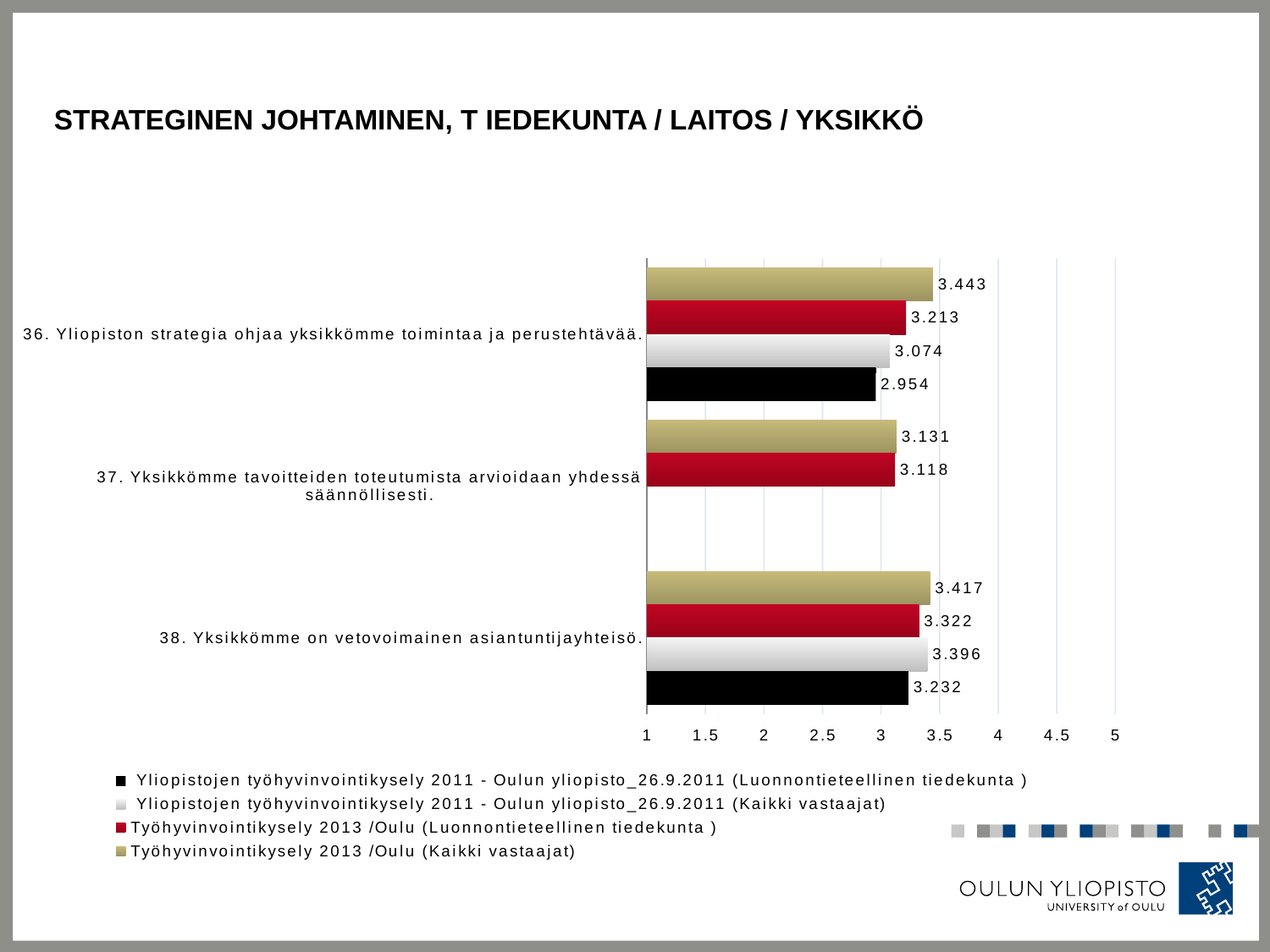
For statement 38, which is larger: the 2011 'Kaikki vastaajat' value or the 2013 'Luonnontieteellinen tiedekunta' value? 2011 'Kaikki vastaajat' (3.396) How many categories (statements) are shown on the chart? 3 What is the value for statement 37 in the series 'Työhyvinvointikysely 2013 /Oulu (Luonnontieteellinen tiedekunta )'? 3.118 Which statement has no values shown for the 2011 survey series? 37. Yksikkömme tavoitteiden toteutumista arvioidaan yhdessä säännöllisesti. What is the value for statement 36 in the series 'Yliopistojen työhyvinvointikysely 2011 - Oulun yliopisto_26.9.2011 (Luonnontieteellinen tiedekunta )'? 2.954 Which statement has the highest value in the series 'Työhyvinvointikysely 2013 /Oulu (Kaikki vastaajat)'? 36. Yliopiston strategia ohjaa yksikkömme toimintaa ja perustehtävää. What is the value for statement 36 in the series 'Työhyvinvointikysely 2013 /Oulu (Kaikki vastaajat)'? 3.443 What is the difference between the 2013 'Kaikki vastaajat' value and the 2011 'Luonnontieteellinen tiedekunta' value for statement 36? 0.489 Which statement has the lowest value in the series 'Työhyvinvointikysely 2013 /Oulu (Luonnontieteellinen tiedekunta )'? 37. Yksikkömme tavoitteiden toteutumista arvioidaan yhdessä säännöllisesti. What is the value for statement 38 in the series 'Yliopistojen työhyvinvointikysely 2011 - Oulun yliopisto_26.9.2011 (Kaikki vastaajat)'? 3.396 How many series does the legend list? 4 What kind of chart is shown on the slide? bar chart